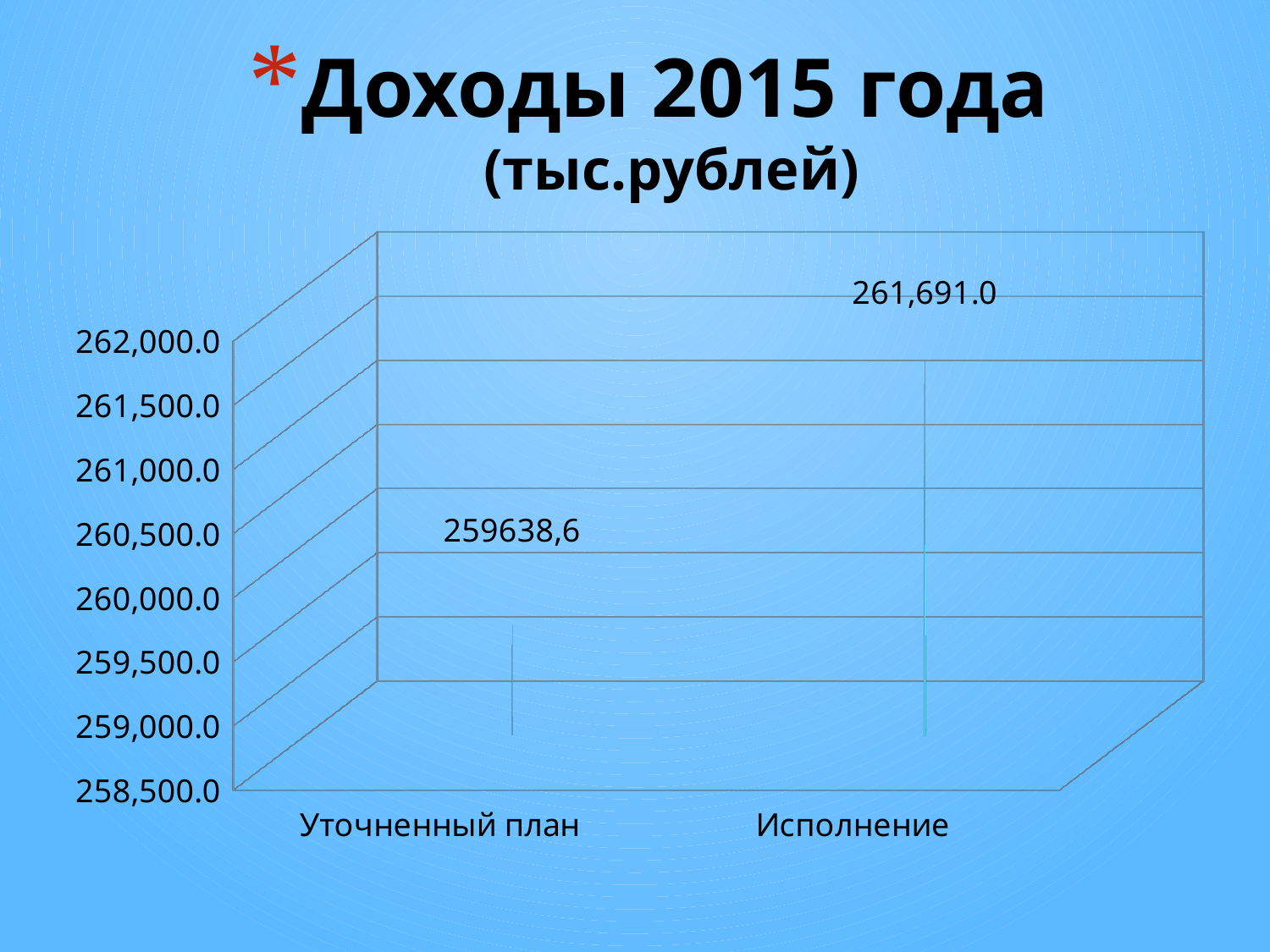
Is the value for Исполнение greater or less than 261,500.0? greater What is the title of the slide? Доходы 2015 года (тыс.рублей) What is the lowest value shown on the vertical axis? 258,500.0 What kind of chart is shown on the slide? bar chart Which category has the lowest value? Уточненный план What is the value for Уточненный план? 259638,6 Which is larger, Уточненный план or Исполнение? Исполнение What is the value for Исполнение? 261,691.0 Which category has the highest value? Исполнение Is the value for Уточненный план greater or less than 260,000.0? less Do the values rise or fall from Уточненный план to Исполнение? rise How many categories are shown on the x axis? 2